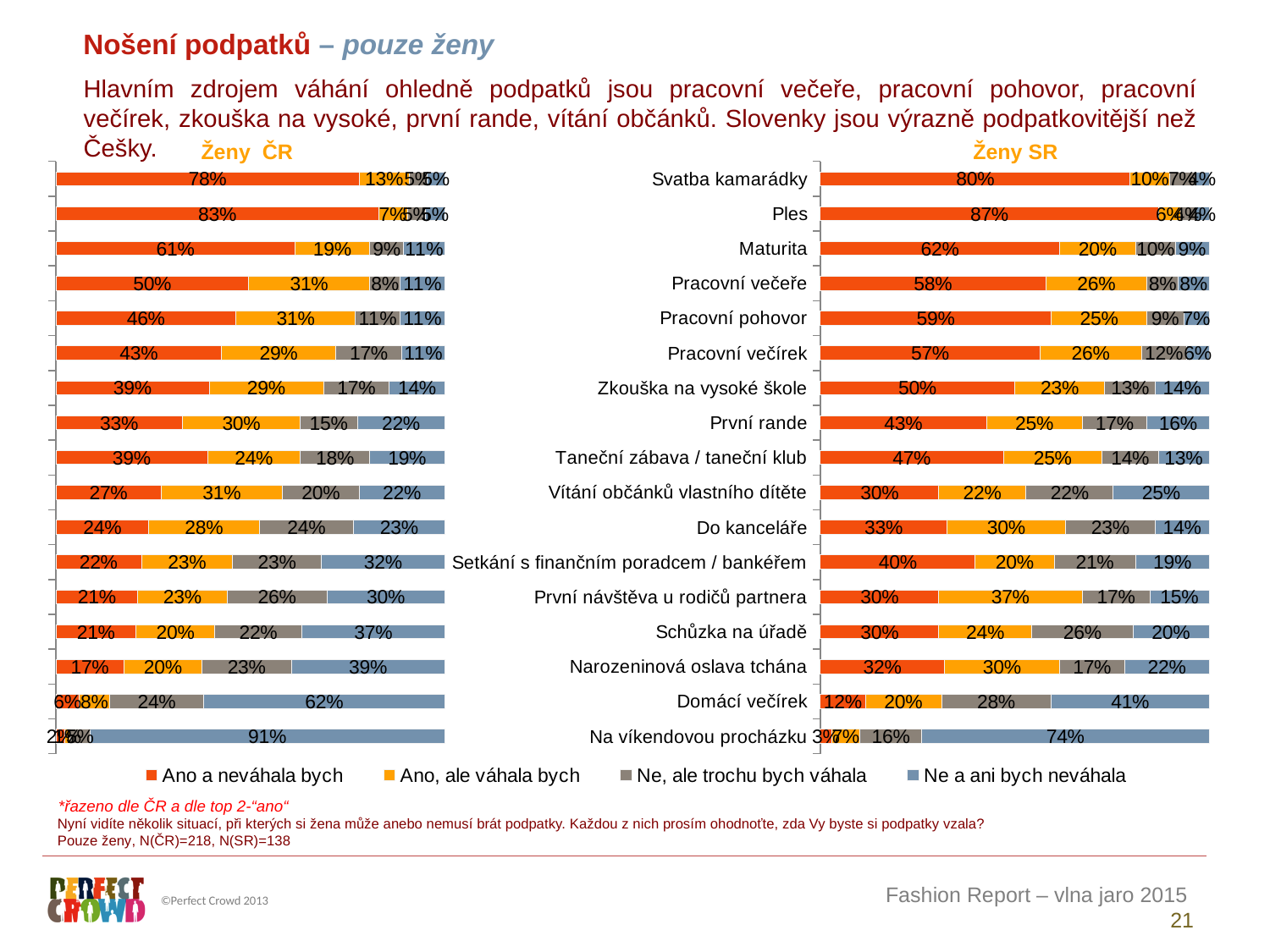
In the Ženy SR chart, which category has the highest value for 'Ano a neváhala bych'? Ples In the Ženy SR chart, what is the value of 'Ano, ale váhala bych' for První návštěva u rodičů partnera? 37% In the Ženy ČR chart, which category has the lowest value for 'Ano a neváhala bych'? Na víkendovou procházku In the Ženy SR chart, what is the value of 'Ne, ale trochu bych váhala' for Schůzka na úřadě? 26% What is the difference between the 'Ano a neváhala bych' value for Pracovní večírek in the Ženy SR chart and in the Ženy ČR chart? 14% In the Ženy ČR chart, which category has the highest value for 'Ne a ani bych neváhala'? Na víkendovou procházku What type of chart is used on this slide? Stacked bar chart In the Ženy ČR chart, what is the value of 'Ano a neváhala bych' for Maturita? 61% How many series does the legend list? 4 How many situations (categories) are listed in the charts? 17 Which is larger: the 'Ano a neváhala bych' value for Setkání s finančním poradcem / bankéřem in the Ženy SR chart or in the Ženy ČR chart? Ženy SR In the Ženy ČR chart, what is the value of 'Ne a ani bych neváhala' for Domácí večírek? 62%